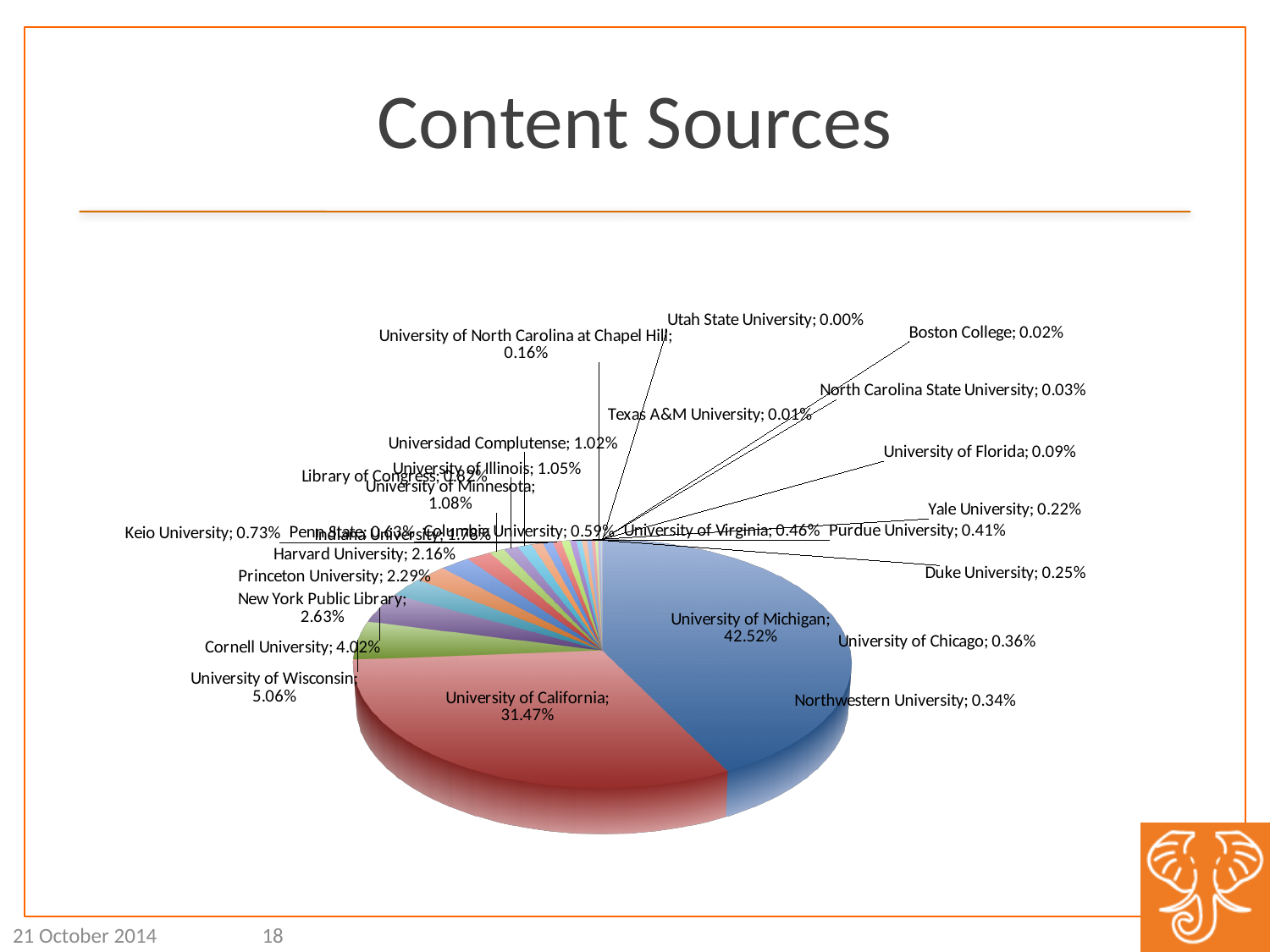
What is the title of the chart? Content Sources Which has a larger share, University of Wisconsin or Cornell University? University of Wisconsin What share of the pie does University of California have? 31.47% Which content source has the smallest share of the pie? Utah State University What is the difference between the shares of University of Michigan and University of California? 11.05% What is the combined share of University of Michigan and University of California? 73.99% What is the value shown for Boston College? 0.02% What is the value shown for University of Wisconsin? 5.06% What kind of chart is shown on the slide? pie chart Which content source has the largest share of the pie? University of Michigan What is the value shown for Cornell University? 4.02% What share of the pie does University of Michigan have? 42.52%